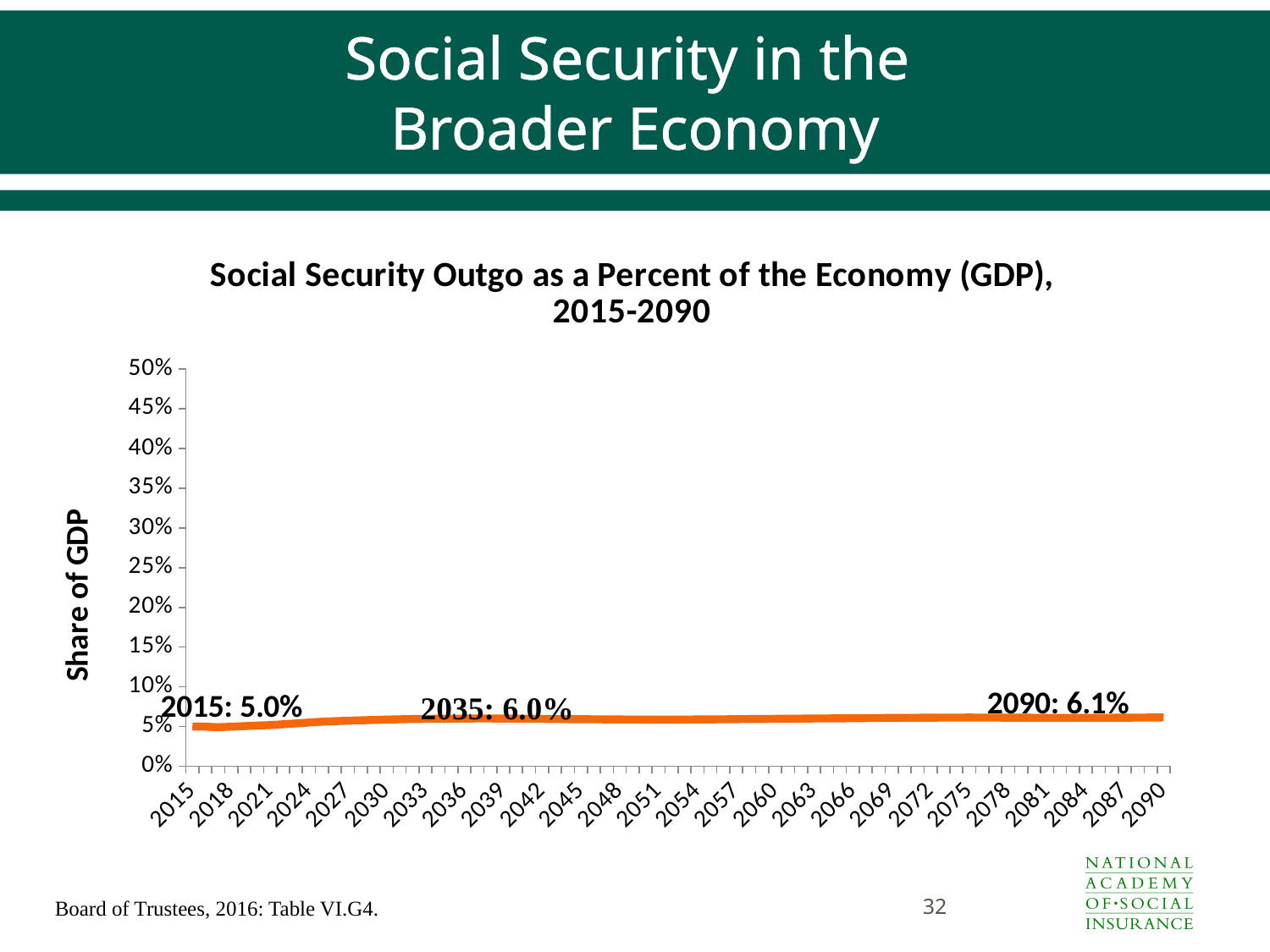
Of the three labeled years, which has the highest share of GDP? 2090 What kind of chart is shown on the slide? line chart What is the Social Security outgo as a percent of GDP in 2090? 6.1% By how many percentage points does the labeled value for 2035 exceed the labeled value for 2015? 1.0 percentage points Which year has the larger labeled value, 2015 or 2035? 2035 What is the Social Security outgo as a percent of GDP in 2035? 6.0% What is the highest value shown on the vertical axis? 50% Does the share of GDP rise or fall from 2015 to 2090? rise Of the three labeled years, which has the lowest share of GDP? 2015 What is the Social Security outgo as a percent of GDP in 2015? 5.0% What is the label on the vertical axis of the chart? Share of GDP Is the value for 2060 greater or less than 10%? less